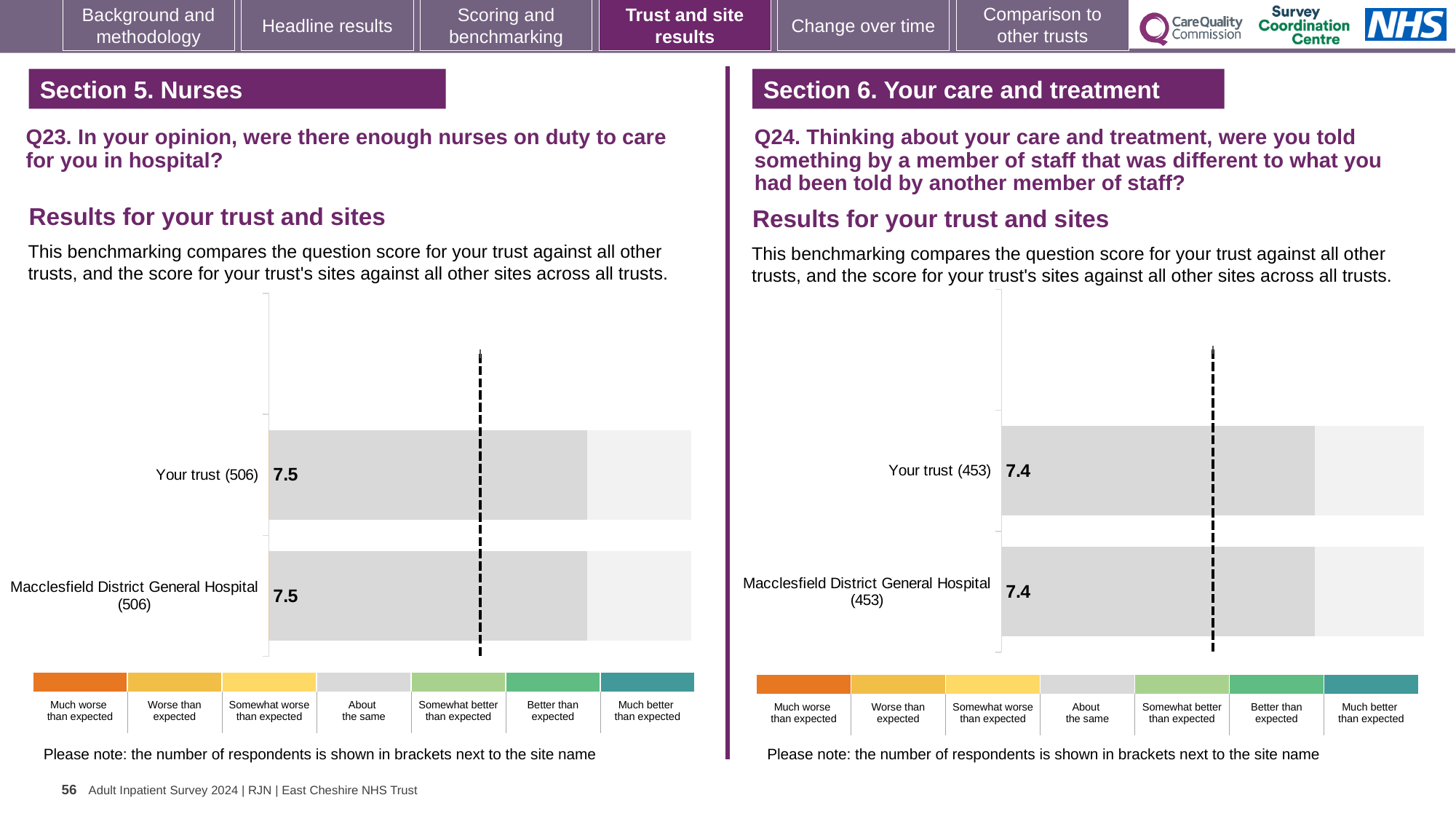
In the Q24 chart on the right, what is the score for Your trust (453)? 7.4 How many bars are plotted in the Q23 chart on the left? 2 In the Q23 chart on the left, what is the score for Macclesfield District General Hospital (506)? 7.5 How many bars are plotted in the Q24 chart on the right? 2 In the Q23 chart on the left, how many respondents are shown in brackets for Your trust? 506 What type of chart is used for the Q23 results on the left? Bar chart In the Q23 chart on the left, what is the score for Your trust (506)? 7.5 In the Q23 chart on the left, what is the difference between the score for Your trust and the score for Macclesfield District General Hospital? 0 How many benchmark categories are shown in the colour legend below the Q23 chart on the left? 7 In the Q24 chart on the right, how many respondents are shown in brackets for Macclesfield District General Hospital? 453 In the Q24 chart on the right, what is the difference between the score for Your trust and the score for Macclesfield District General Hospital? 0 In the Q24 chart on the right, what is the score for Macclesfield District General Hospital (453)? 7.4